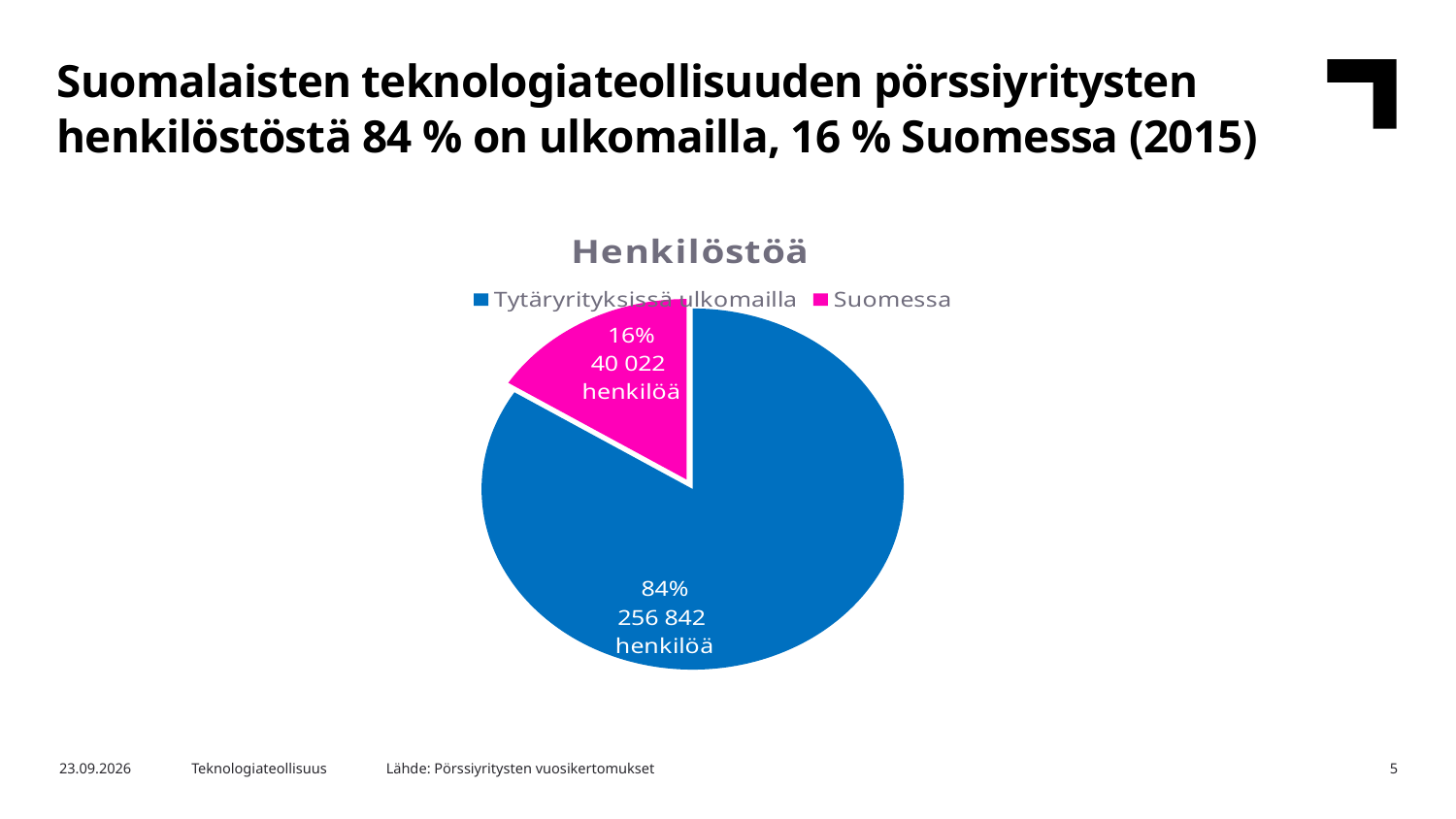
How many entries does the legend list? 2 How many slices does the pie chart have? 2 How many people does the 'Tytäryrityksissä ulkomailla' slice represent? 256 842 henkilöä How many people does the 'Suomessa' slice represent? 40 022 henkilöä Which is larger, the 'Suomessa' slice or the 'Tytäryrityksissä ulkomailla' slice? Tytäryrityksissä ulkomailla What is the title of the chart? Henkilöstöä What share of the pie does the 'Tytäryrityksissä ulkomailla' slice represent? 84% What is the difference in headcount between 'Tytäryrityksissä ulkomailla' and 'Suomessa'? 216 820 What kind of chart is shown on the slide? Pie chart What share of the pie does the 'Suomessa' slice represent? 16% Which slice is the largest? Tytäryrityksissä ulkomailla Which slice is the smallest? Suomessa